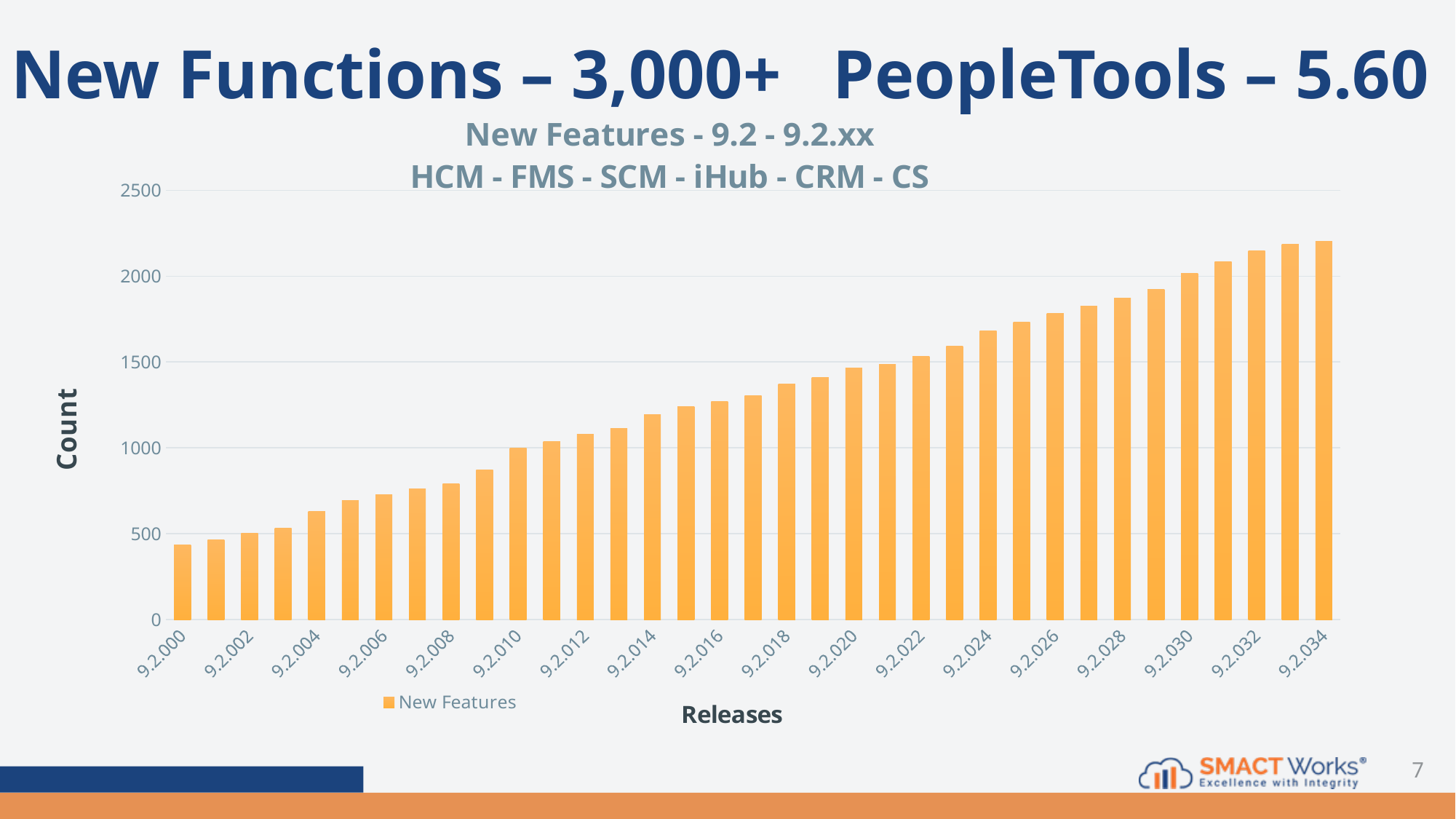
What is the label of the vertical axis? Count Is the value for 9.2.024 greater or less than 1500? greater How many series does the legend list? 1 Is the value for 9.2.028 greater or less than 2000? less Which is larger, the value for 9.2.020 or the value for 9.2.010? 9.2.020 Which release has the highest count of new features? 9.2.034 Do the values rise or fall from 9.2.000 to 9.2.034? rise Is the value for 9.2.000 greater or less than 500? less Which release has the lowest count of new features? 9.2.000 What kind of chart is shown on the slide? bar chart